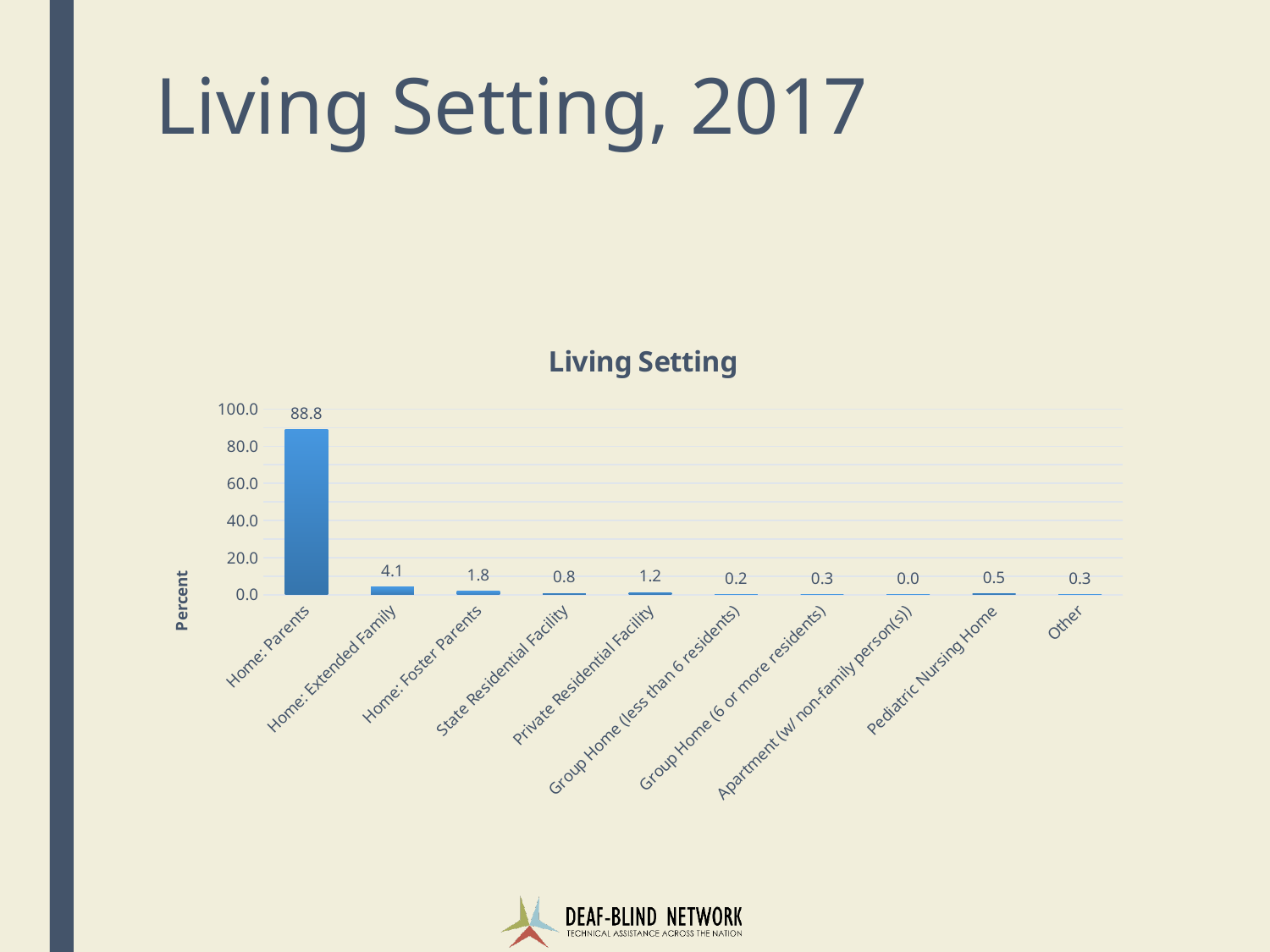
How many categories are shown on the x axis? 10 What is the label of the vertical axis? Percent Which is larger, the value for Home: Foster Parents or the value for State Residential Facility? Home: Foster Parents Which category has the highest value? Home: Parents What is the value for Private Residential Facility? 1.2 What is the difference between the values for Home: Parents and Home: Extended Family? 84.7 Is the value for Home: Parents greater or less than 80.0? greater What is the value for Home: Parents? 88.8 What is the value for Home: Extended Family? 4.1 What is the value for Pediatric Nursing Home? 0.5 What kind of chart is this? bar chart Which category has the lowest value? Apartment (w/ non-family person(s))